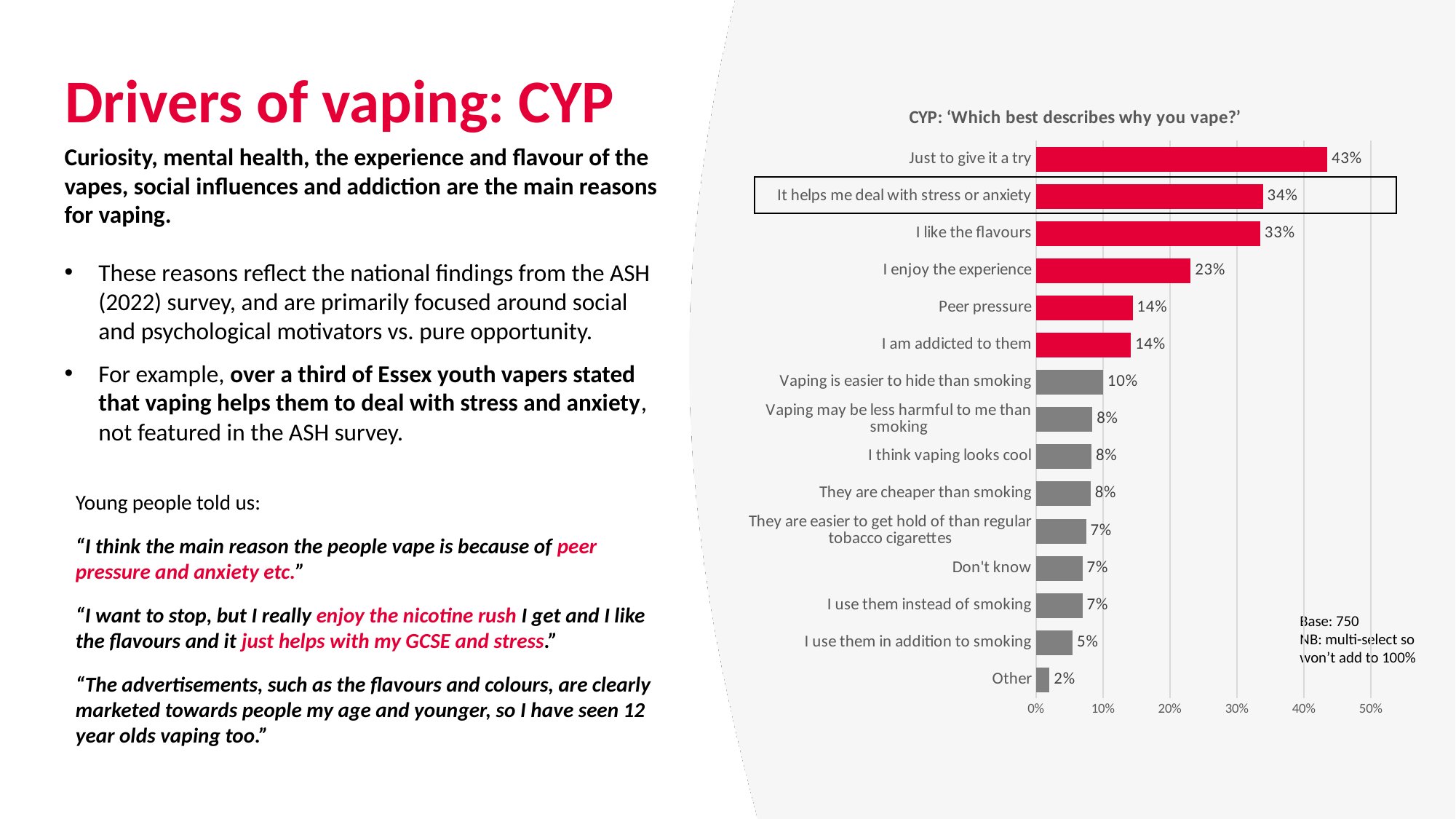
What is the value for 'It helps me deal with stress or anxiety'? 34% Which reason has the highest percentage? Just to give it a try What is the value for 'Other'? 2% What percentage chose 'I am addicted to them'? 14% How many reasons are listed in the chart? 15 Is the value for 'I like the flavours' greater or less than 30%? greater What is the difference between 'Just to give it a try' and 'I like the flavours'? 10% What percentage of respondents said 'Just to give it a try'? 43% Which reason has the lowest percentage? Other What kind of chart is shown on the slide? Bar chart Which is larger: 'I enjoy the experience' or 'Vaping is easier to hide than smoking'? I enjoy the experience What is the title of the chart? CYP: 'Which best describes why you vape?'